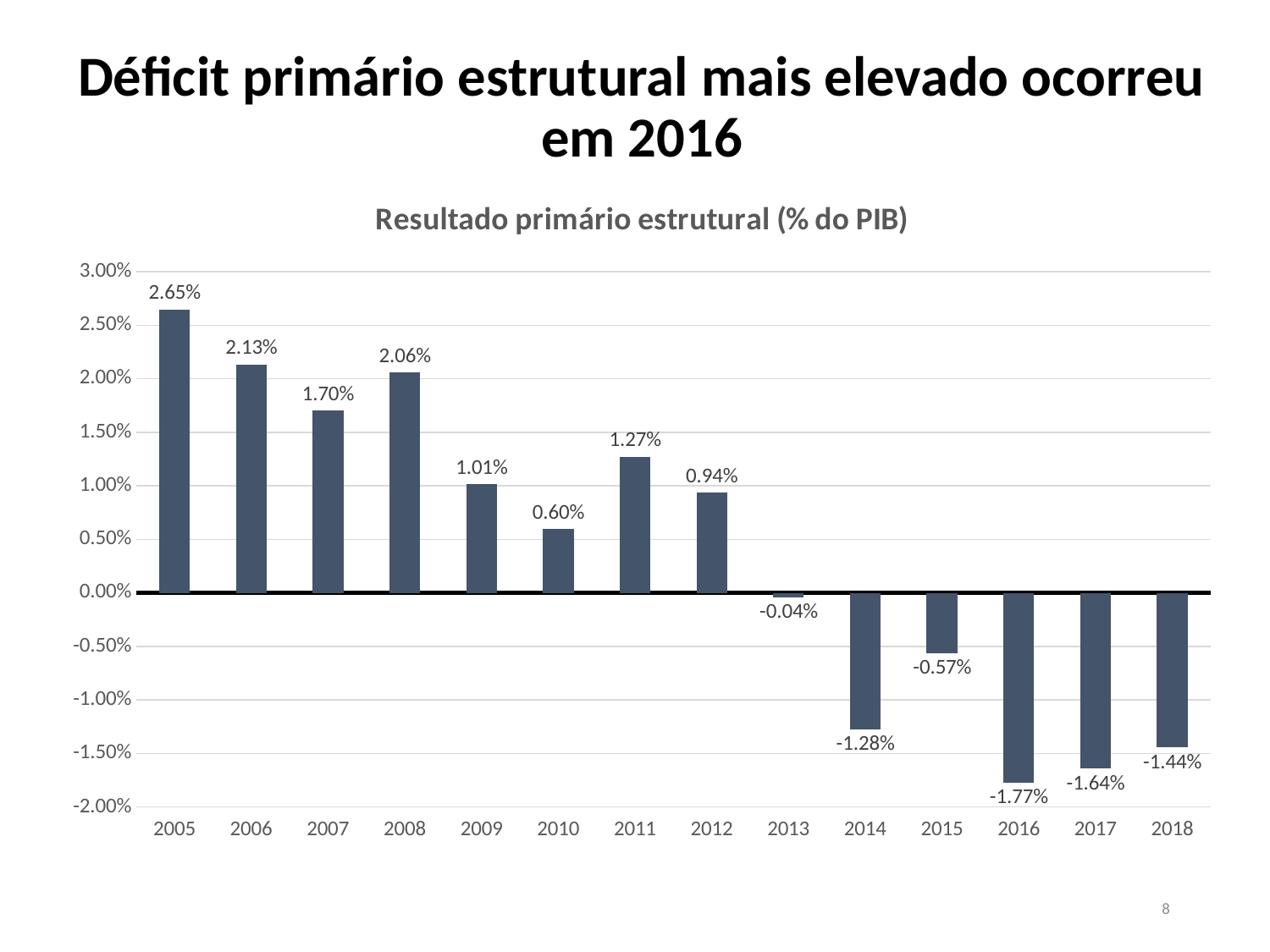
Which is larger, the value for 2008 or the value for 2007? 2008 Which year has the lowest value? 2016 How many years are shown on the x axis? 14 Is the value for 2011 greater or less than 1.00%? greater What is the value for 2005? 2.65% Which year has the highest value? 2005 What is the value for 2013? -0.04% What is the title of the chart? Resultado primário estrutural (% do PIB) What kind of chart is shown? bar chart Do the values generally rise or fall from 2005 to 2018? fall What is the difference between the values for 2005 and 2006? 0.52% What is the value for 2016? -1.77%